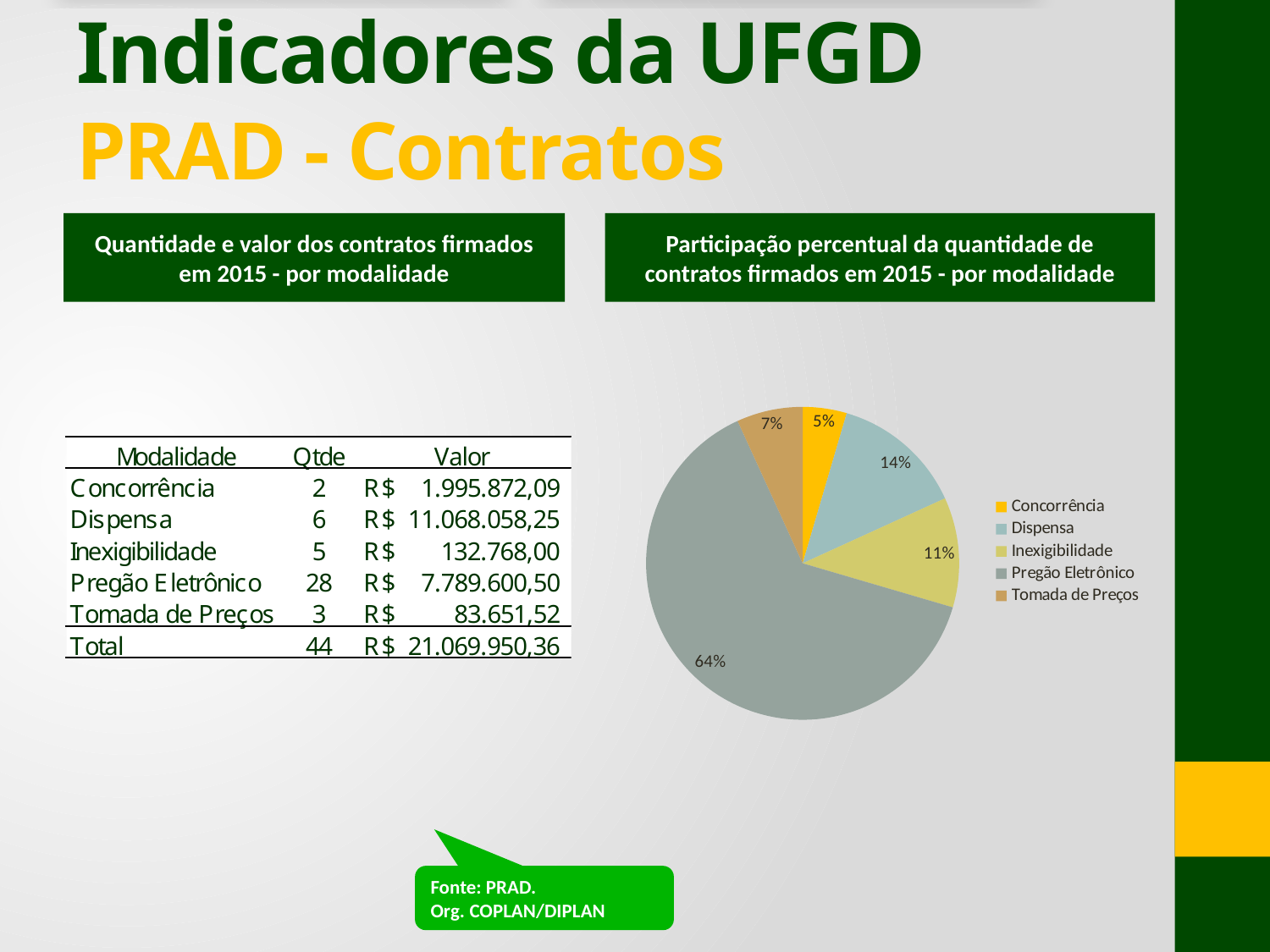
Which modality has the largest slice in the pie chart? Pregão Eletrônico What is the title above the pie chart? Participação percentual da quantidade de contratos firmados em 2015 - por modalidade In the pie chart, which has a larger share, Tomada de Preços or Concorrência? Tomada de Preços In the pie chart, what percentage share does Dispensa have? 14% In the pie chart, what percentage share does Inexigibilidade have? 11% What kind of chart is shown on the slide? pie chart Which modality has the smallest slice in the pie chart? Concorrência In the pie chart, what percentage share does Tomada de Preços have? 7% In the pie chart, what percentage share does Pregão Eletrônico have? 64% In the pie chart, what is the difference in percentage points between Dispensa and Inexigibilidade? 3 How many slices does the pie chart have? 5 In the pie chart, what percentage share does Concorrência have? 5%